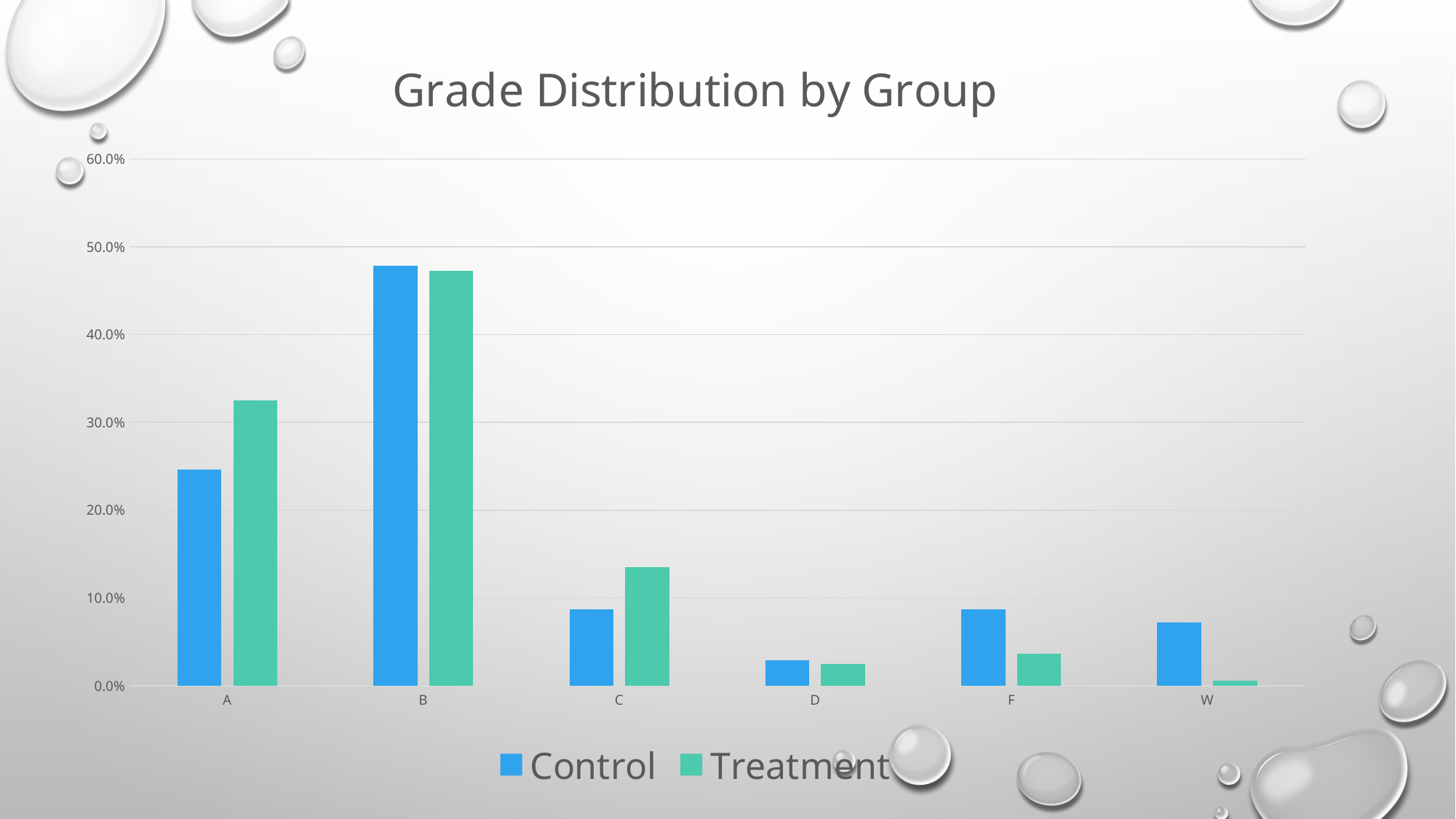
For grade A, which group has the larger value, Control or Treatment? Treatment How many series does the legend list? 2 Is the Treatment value for grade A greater or less than 30.0%? greater Is the Control value for grade C greater or less than 10.0%? less Which grade has the lowest value for the Treatment group? W What type of chart is shown on the slide? bar chart What is the title of the chart? Grade Distribution by Group Is the Control value for grade B greater or less than 40.0%? greater Which grade has the lowest value for the Control group? D For grade F, which group has the larger value, Control or Treatment? Control Which grade has the highest value for the Control group? B How many grade categories are shown on the x axis? 6